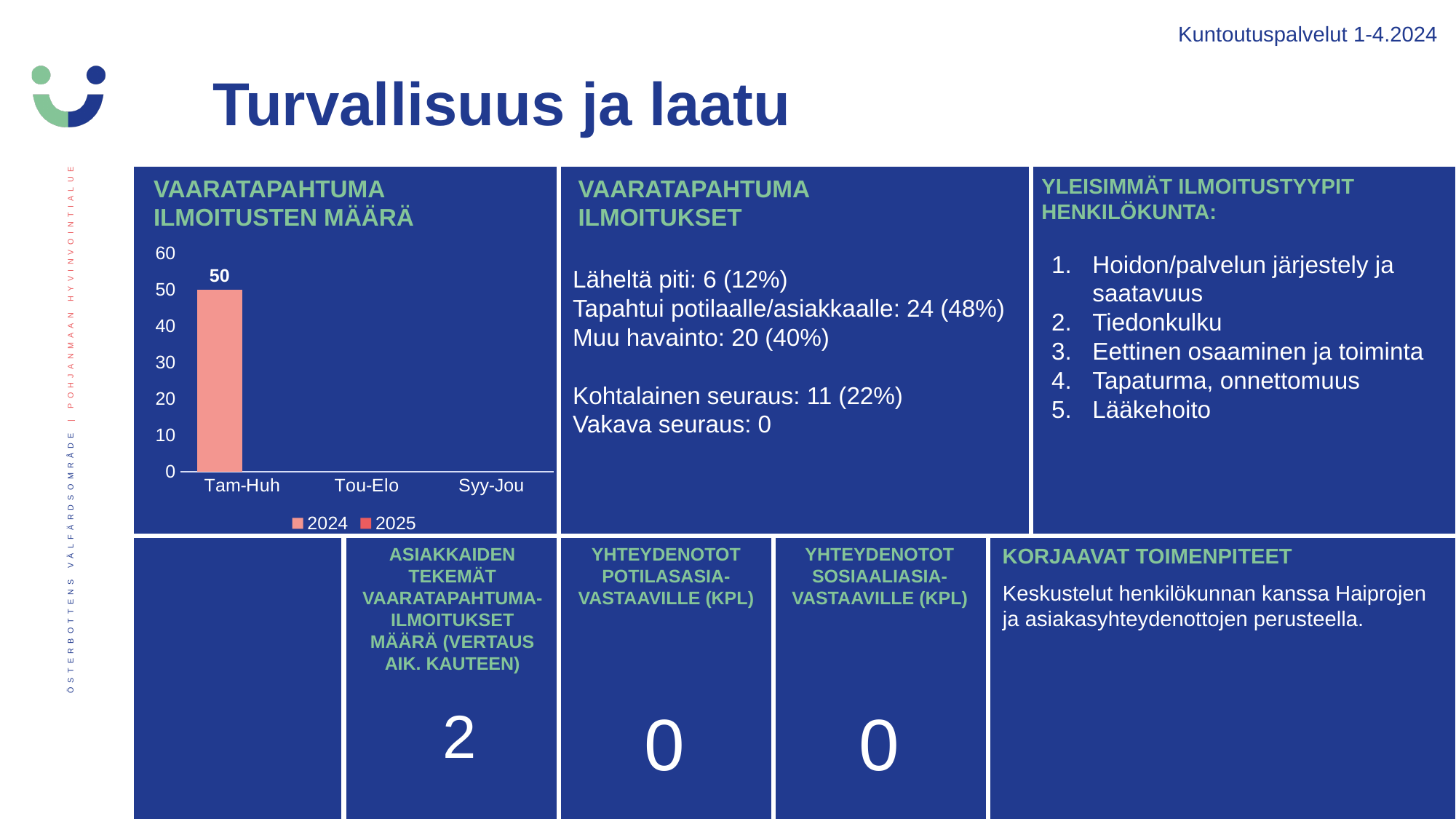
What is the value of the 2024 bar for Tam-Huh in the chart? 50 Is the value for Tam-Huh (2024) greater or less than 40? greater What kind of chart is shown on the slide? bar chart How many series does the chart legend list? 2 What is the maximum value shown on the chart's y axis? 60 Which series are listed in the chart legend? 2024 and 2025 Which category has the highest value in the chart? Tam-Huh Which category is the first one on the x axis of the chart? Tam-Huh What is the title of the chart on the slide? VAARATAPAHTUMA ILMOITUSTEN MÄÄRÄ How many categories are shown on the x axis of the chart? 3 Is the value for Tam-Huh (2024) greater or less than 60? less